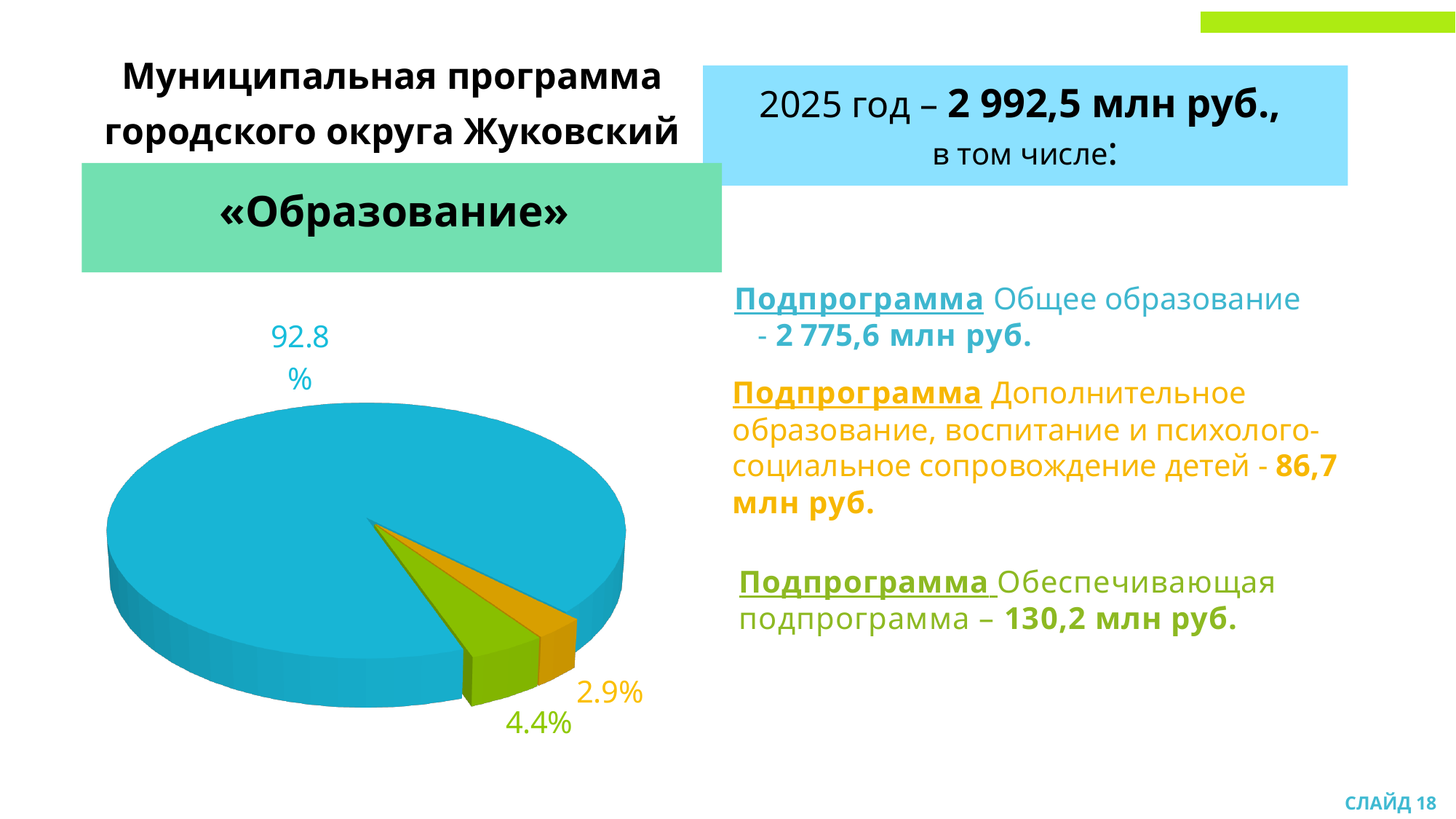
Which is larger in the pie chart, the green slice or the orange slice? the green slice Which slice of the pie chart is the largest? the blue slice (92.8%) How many slices does the pie chart have? 3 What percentage is shown for the orange slice of the pie chart? 2.9% What kind of chart is shown on the slide? pie chart What percentage is shown for the green slice of the pie chart? 4.4% What is the difference in percentage points between the green slice (4.4%) and the orange slice (2.9%) of the pie chart? 1.5 What colour is the slice of the pie chart labelled 2.9%? orange What percentage is shown for the largest (blue) slice of the pie chart? 92.8% What is the difference in percentage points between the blue slice (92.8%) and the green slice (4.4%) of the pie chart? 88.4 Which slice of the pie chart is the smallest? the orange slice (2.9%) Is the value of the blue slice of the pie chart greater or less than 90%? greater